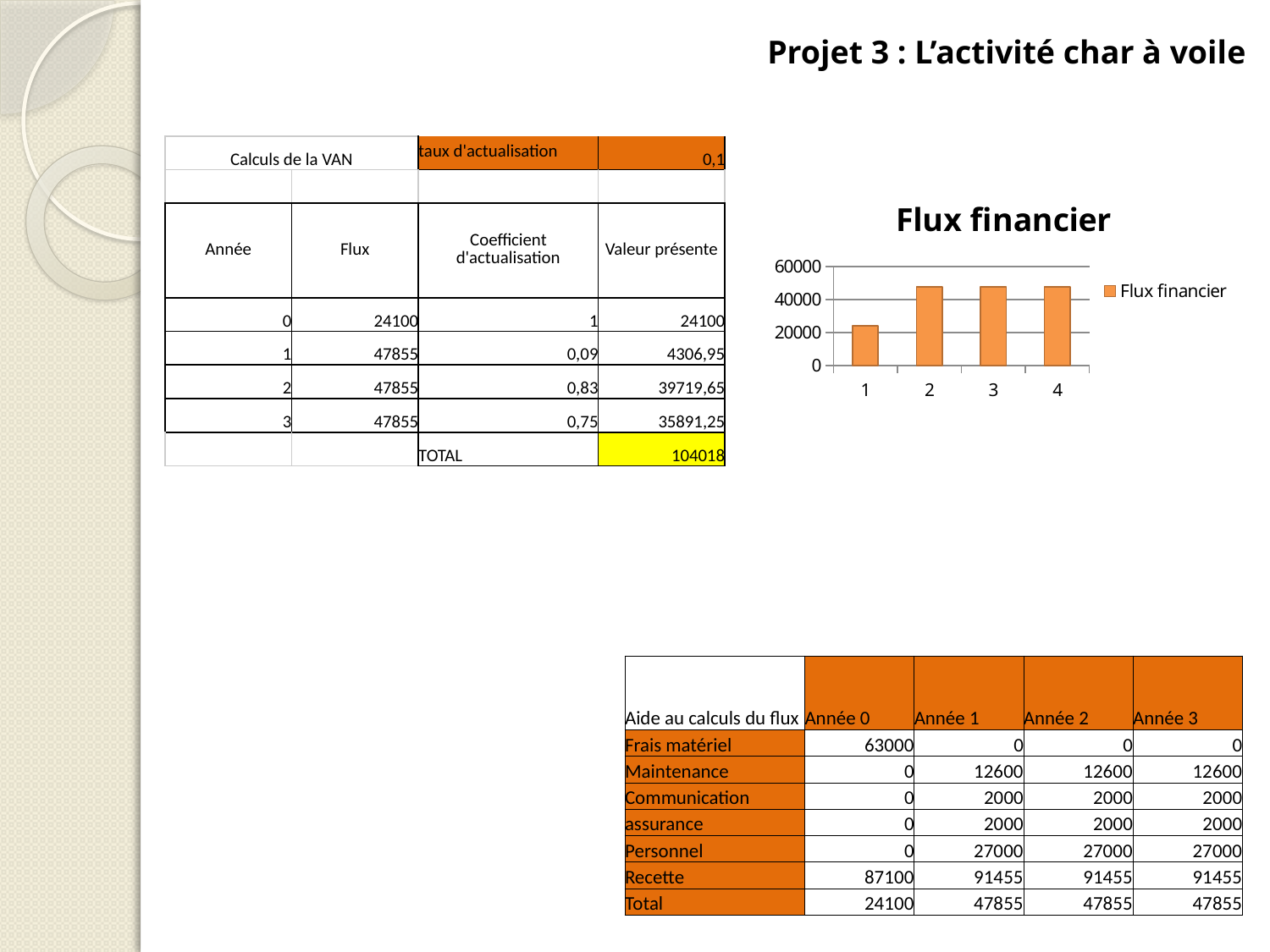
In the "Flux financier" chart, is the value for category 1 greater or less than 40000? less How many bars are plotted in the "Flux financier" chart? 4 What is the legend entry shown in the "Flux financier" chart? Flux financier What kind of chart is the "Flux financier" chart? bar chart What is the title of the chart on the slide? Flux financier In the "Flux financier" chart, is the value for category 3 greater or less than 60000? less In the "Flux financier" chart, which category has the lowest bar? 1 In the "Flux financier" chart, does the value rise or fall from category 1 to category 2? rise In the "Flux financier" chart, is the value for category 1 greater or less than 20000? greater In the "Flux financier" chart, which is larger, the value for category 1 or the value for category 2? category 2 How many series does the legend of the "Flux financier" chart list? 1